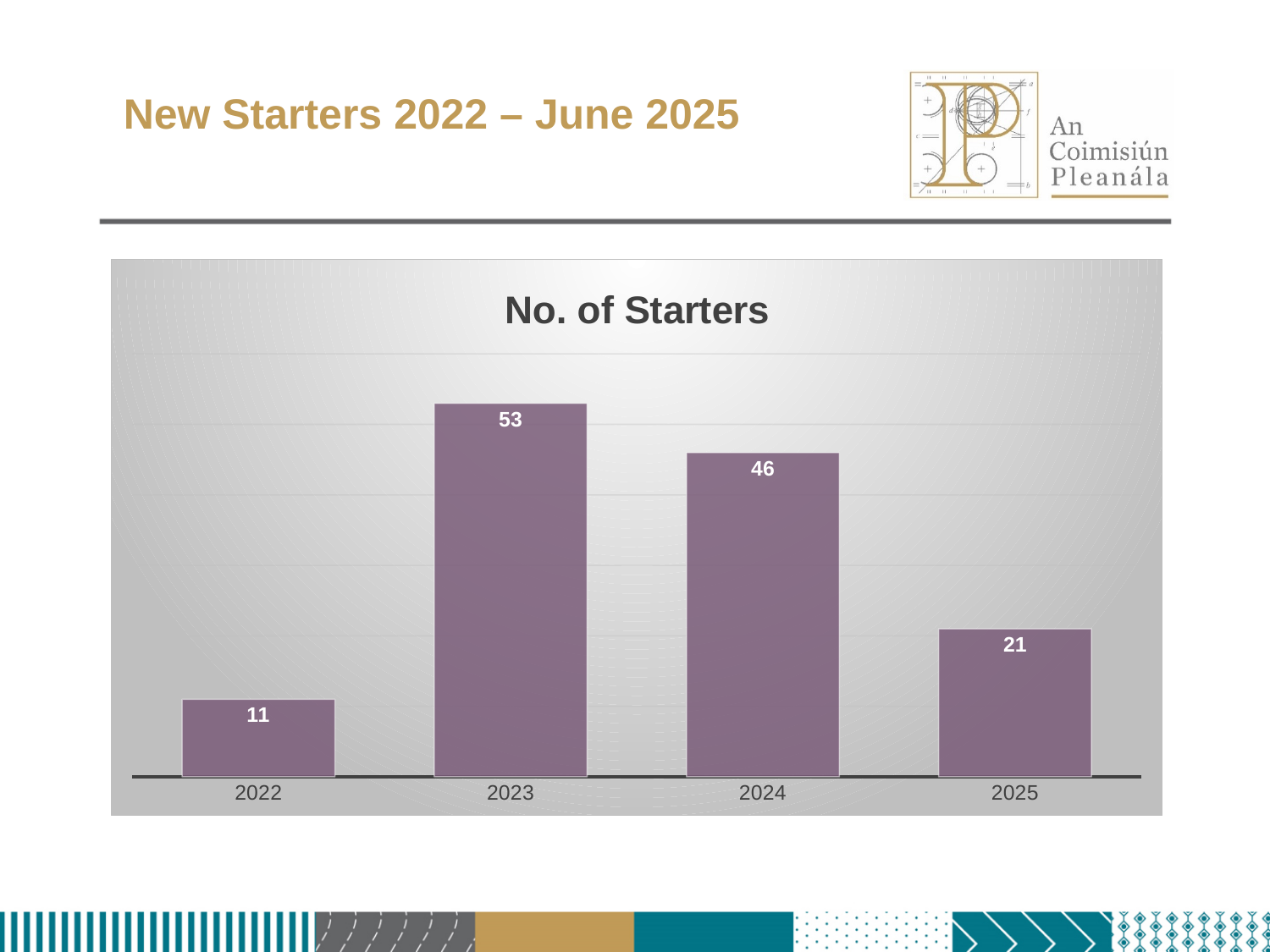
What is the number of starters in 2025? 21 Does the number of starters rise or fall from 2023 to 2025? Fall How many years are shown on the chart? 4 What kind of chart is shown on the slide? Bar chart Which year has the lowest number of starters? 2022 Which year had more starters, 2024 or 2025? 2024 What is the title of the chart? No. of Starters What is the difference in the number of starters between 2025 and 2022? 10 What is the difference in the number of starters between 2023 and 2024? 7 Which year has the highest number of starters? 2023 What is the number of starters in 2022? 11 What is the number of starters in 2023? 53